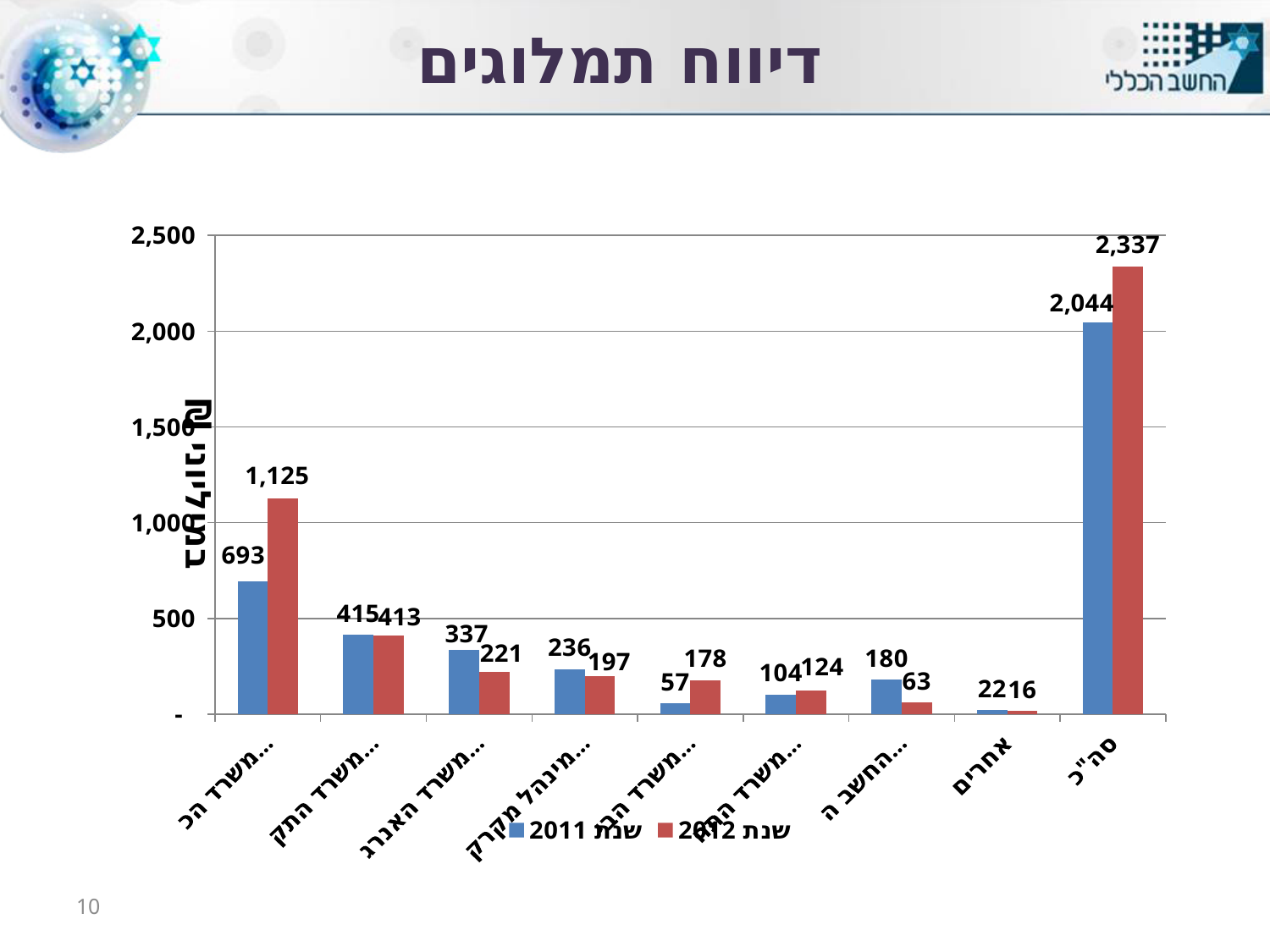
What kind of chart is shown on the slide? Bar chart How many series does the legend list? 2 What are the two legend entries of the chart? שנת 2011 and שנת 2012 How many categories are shown on the x axis? 9 What is the value for סה"כ in the שנת 2012 series? 2,337 For אחרים, which series has the larger value, שנת 2011 or שנת 2012? שנת 2011 What is the value for אחרים in the שנת 2012 series? 16 What is the difference between the שנת 2012 and שנת 2011 values for סה"כ? 293 What is the value of the שנת 2012 bar for the leftmost category? 1,125 What is the value for אחרים in the שנת 2011 series? 22 What is the value for סה"כ in the שנת 2011 series? 2,044 Which category has the highest value in the שנת 2012 series? סה"כ